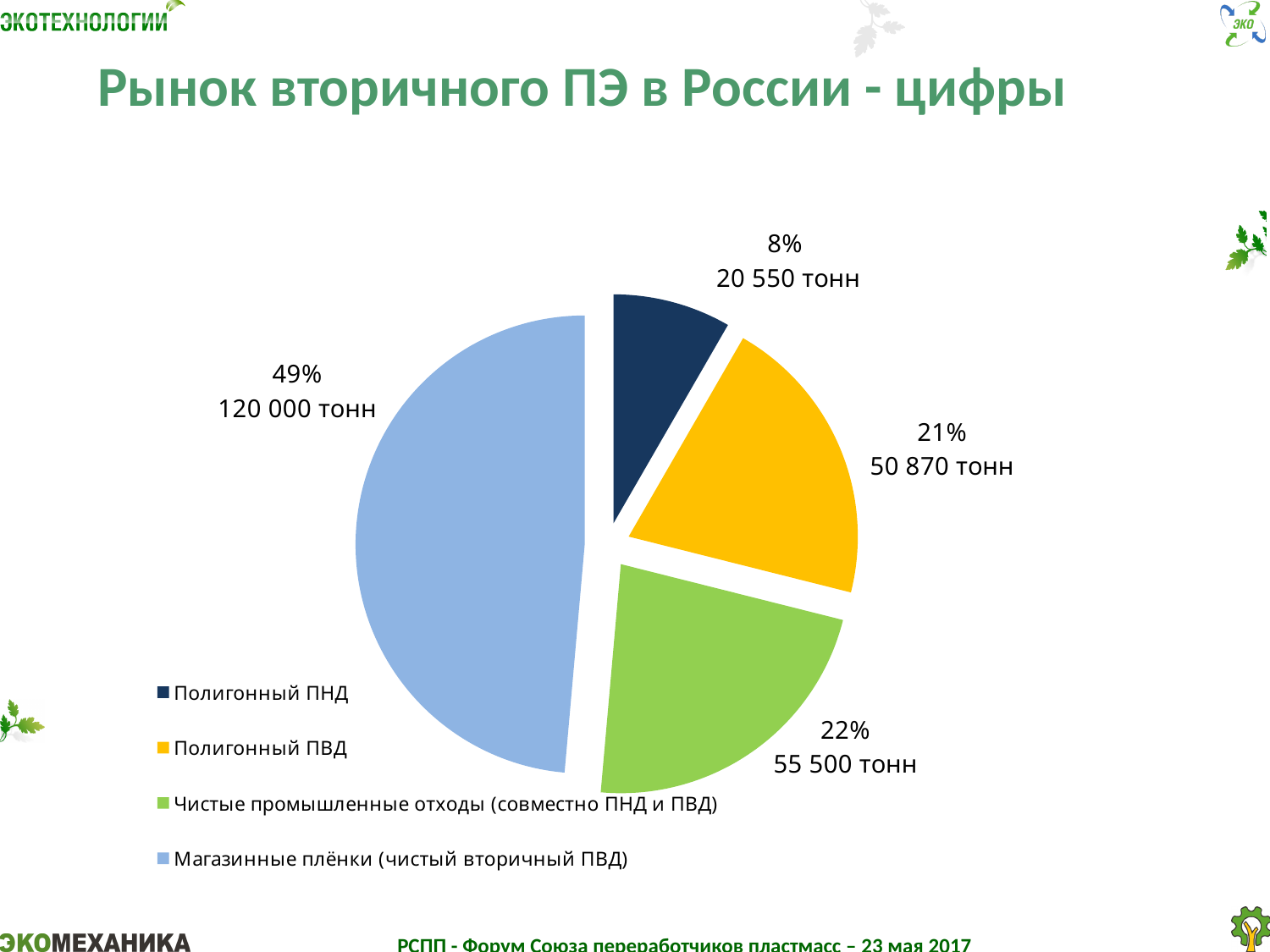
Which category has the largest slice of the pie? Магазинные плёнки (чистый вторичный ПВД) How many slices does the pie chart have? 4 What kind of chart is shown on the slide? pie chart What is the value in tonnes for Чистые промышленные отходы (совместно ПНД и ПВД)? 55 500 тонн Which is larger: the value for Полигонный ПВД or the value for Полигонный ПНД? Полигонный ПВД Which category has the smallest slice of the pie? Полигонный ПНД What is the value in tonnes for Магазинные плёнки (чистый вторичный ПВД)? 120 000 тонн What is the value in tonnes for Полигонный ПВД? 50 870 тонн What share of the pie does Магазинные плёнки (чистый вторичный ПВД) hold? 49% What is the title of the chart slide? Рынок вторичного ПЭ в России - цифры What is the difference in tonnes between Магазинные плёнки (чистый вторичный ПВД) and Полигонный ПНД? 99 450 тонн What share of the pie does Полигонный ПНД hold? 8%